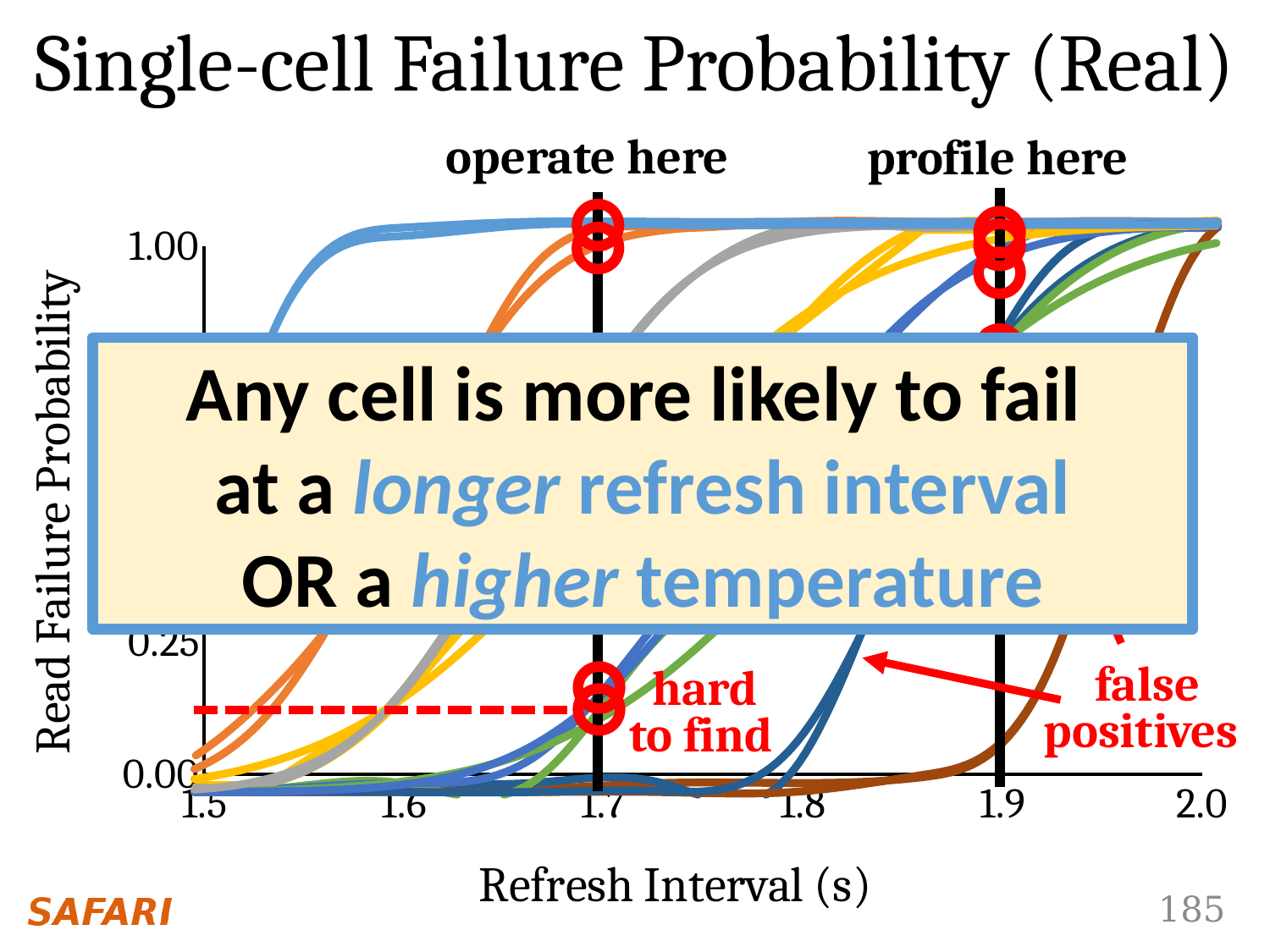
At what refresh interval is the vertical line labelled "operate here" drawn? 1.7 Is the value of the brown curve at a refresh interval of 1.9 s greater or less than 0.25? less What is the highest value shown on the x axis of the chart? 2.0 What is the highest tick value shown on the y axis of the chart? 1.00 Is the value of the light blue curve at a refresh interval of 1.7 s greater or less than 0.75? greater What is the title of the chart on the slide? Single-cell Failure Probability (Real) Is the value of the dark blue curve at a refresh interval of 1.7 s greater or less than 0.25? less What is the lowest value shown on the x axis of the chart? 1.5 What kind of chart is shown on the slide? line chart What is the label of the x axis of the chart? Refresh Interval (s) At what refresh interval is the vertical line labelled "profile here" drawn? 1.9 Do the curves rise or fall as the refresh interval increases along the x axis? rise